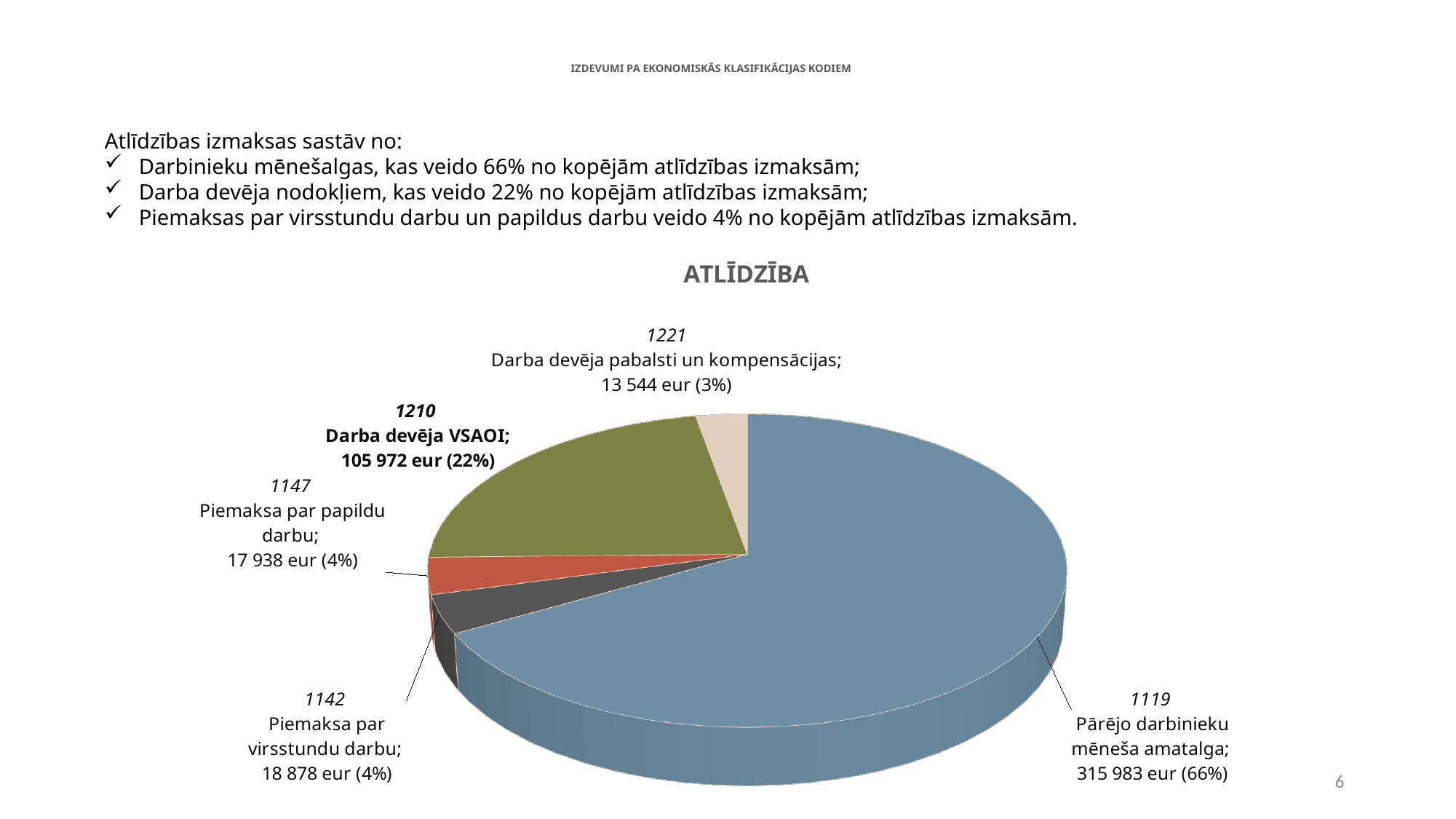
Which is larger, the value for 1210 Darba devēja VSAOI or the value for 1221 Darba devēja pabalsti un kompensācijas? 1210 Darba devēja VSAOI What share of the pie does 1210 Darba devēja VSAOI represent? 22% What is the title of the chart? ATLĪDZĪBA What type of chart is shown on the slide? pie chart What is the value for 1119 Pārējo darbinieku mēneša amatalga? 315 983 eur Which category has the largest slice? 1119 Pārējo darbinieku mēneša amatalga Which category has the smallest slice? 1221 Darba devēja pabalsti un kompensācijas What share of the pie does 1119 Pārējo darbinieku mēneša amatalga represent? 66% What is the value for 1210 Darba devēja VSAOI? 105 972 eur How many slices does the pie chart have? 5 What is the difference between the values for 1142 Piemaksa par virsstundu darbu and 1147 Piemaksa par papildu darbu? 940 eur What is the value for 1221 Darba devēja pabalsti un kompensācijas? 13 544 eur